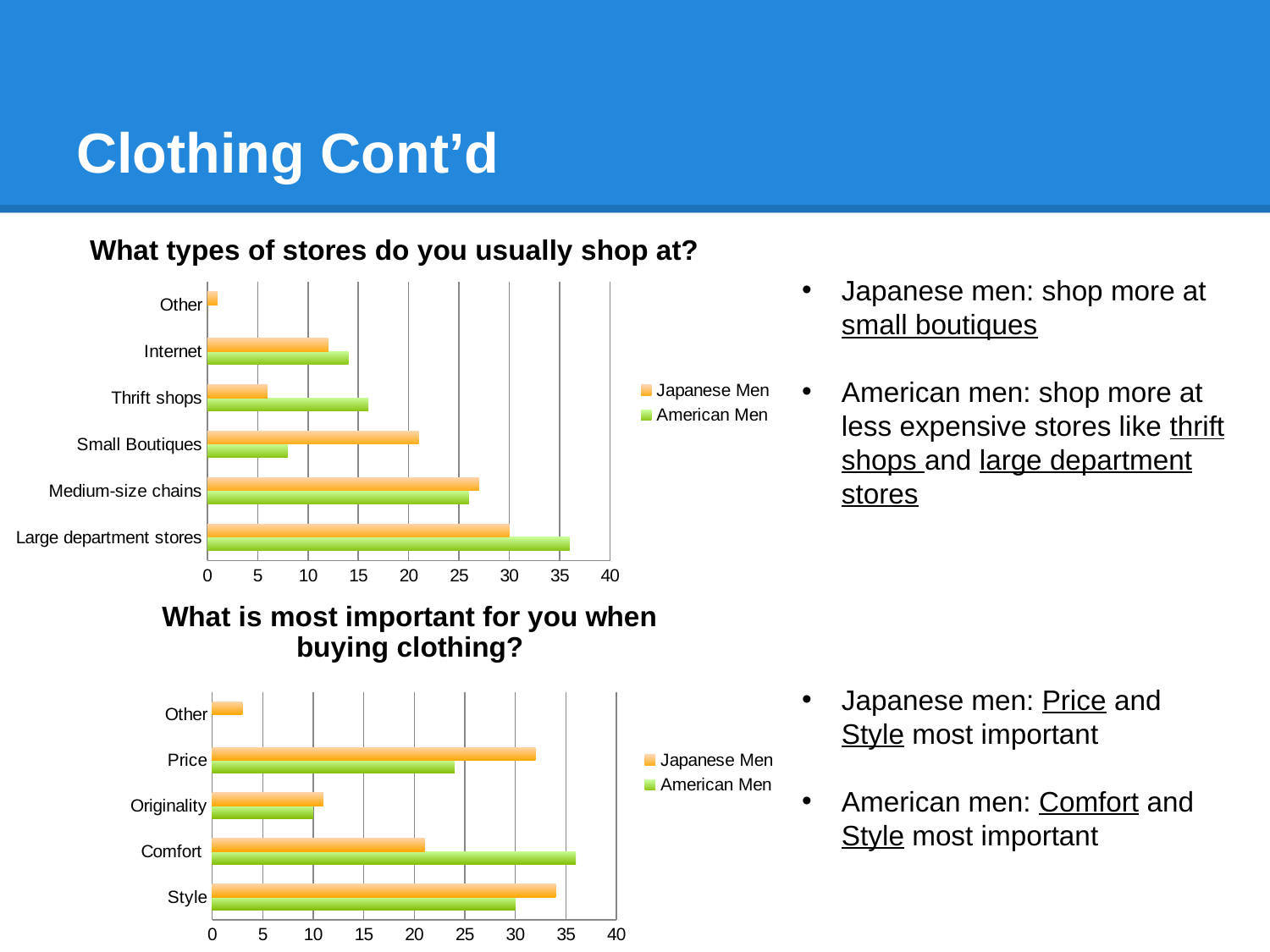
In the chart titled "What types of stores do you usually shop at?", what kind of chart is used? Bar chart In the chart titled "What types of stores do you usually shop at?", how many store categories are shown? 6 In the chart titled "What types of stores do you usually shop at?", which series has the larger value for Small Boutiques, Japanese Men or American Men? Japanese Men In the chart titled "What types of stores do you usually shop at?", is the value for Large department stores for Japanese Men greater or less than 25? greater In the chart titled "What is most important for you when buying clothing?", what colour represents American Men in the legend? Green In the chart titled "What types of stores do you usually shop at?", how many series does the legend list? 2 In the chart titled "What is most important for you when buying clothing?", how many categories are shown? 5 In the chart titled "What types of stores do you usually shop at?", which category has the highest value for American Men? Large department stores In the chart titled "What is most important for you when buying clothing?", which series has the larger value for Price, Japanese Men or American Men? Japanese Men In the chart titled "What is most important for you when buying clothing?", which category has the highest value for American Men? Comfort In the chart titled "What types of stores do you usually shop at?", is the value for Thrift shops for American Men greater or less than 10? greater In the chart titled "What is most important for you when buying clothing?", is the value for Originality for Japanese Men greater or less than 15? less